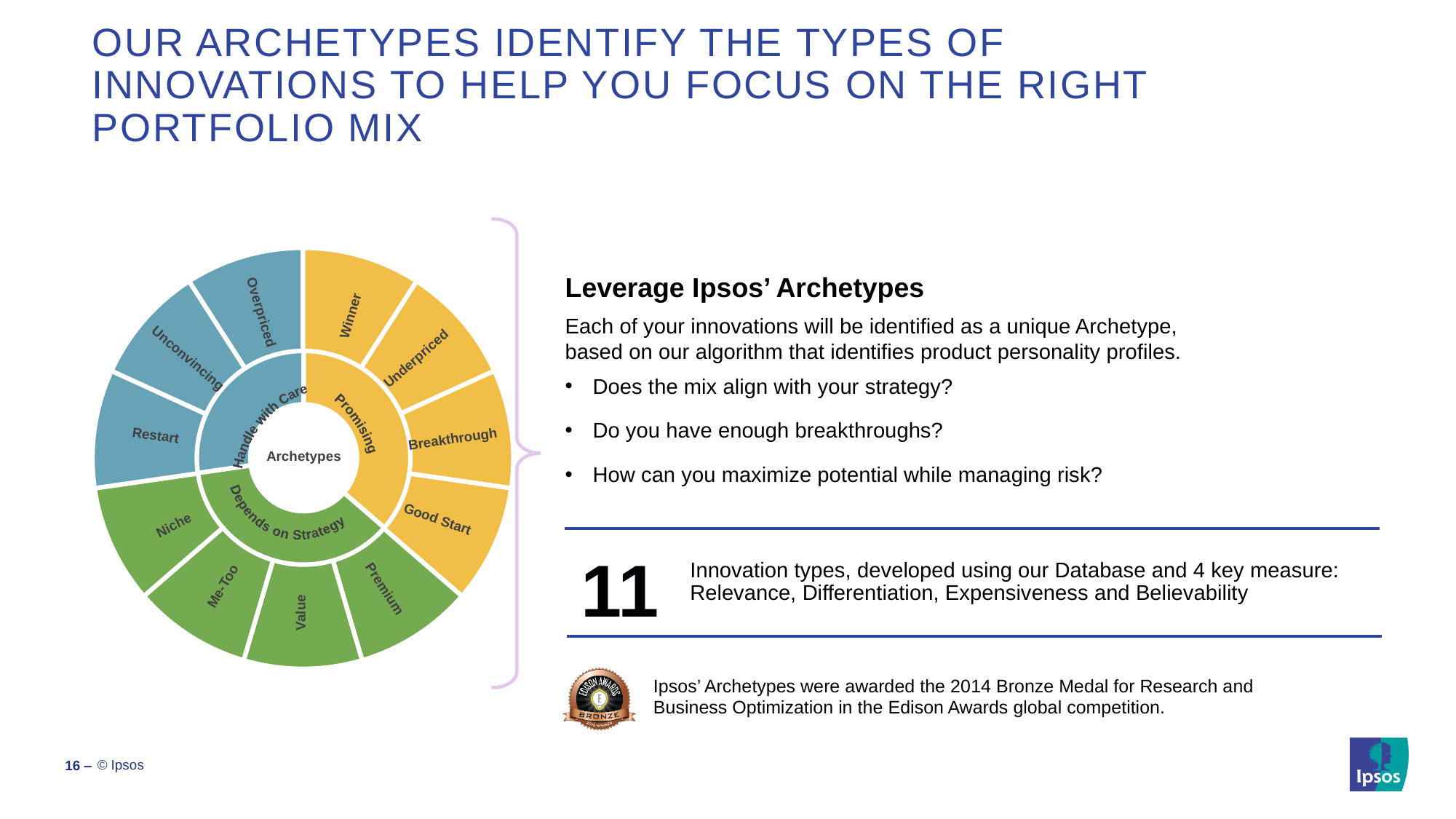
What colour are the 'Handle with Care' segments of the chart? blue What label appears in the centre of the chart? Archetypes How many segments are in the inner ring of the chart? 3 How many outer-ring segments belong to 'Promising'? 4 What kind of chart is shown on the left of the slide? doughnut chart How many outer-ring segments belong to 'Handle with Care'? 3 Which inner-ring category does the outer segment 'Niche' belong to? Depends on Strategy Which inner-ring category has the fewest outer-ring segments? Handle with Care Which inner-ring category does the outer segment 'Restart' belong to? Handle with Care Which inner-ring category does the outer segment 'Winner' belong to? Promising